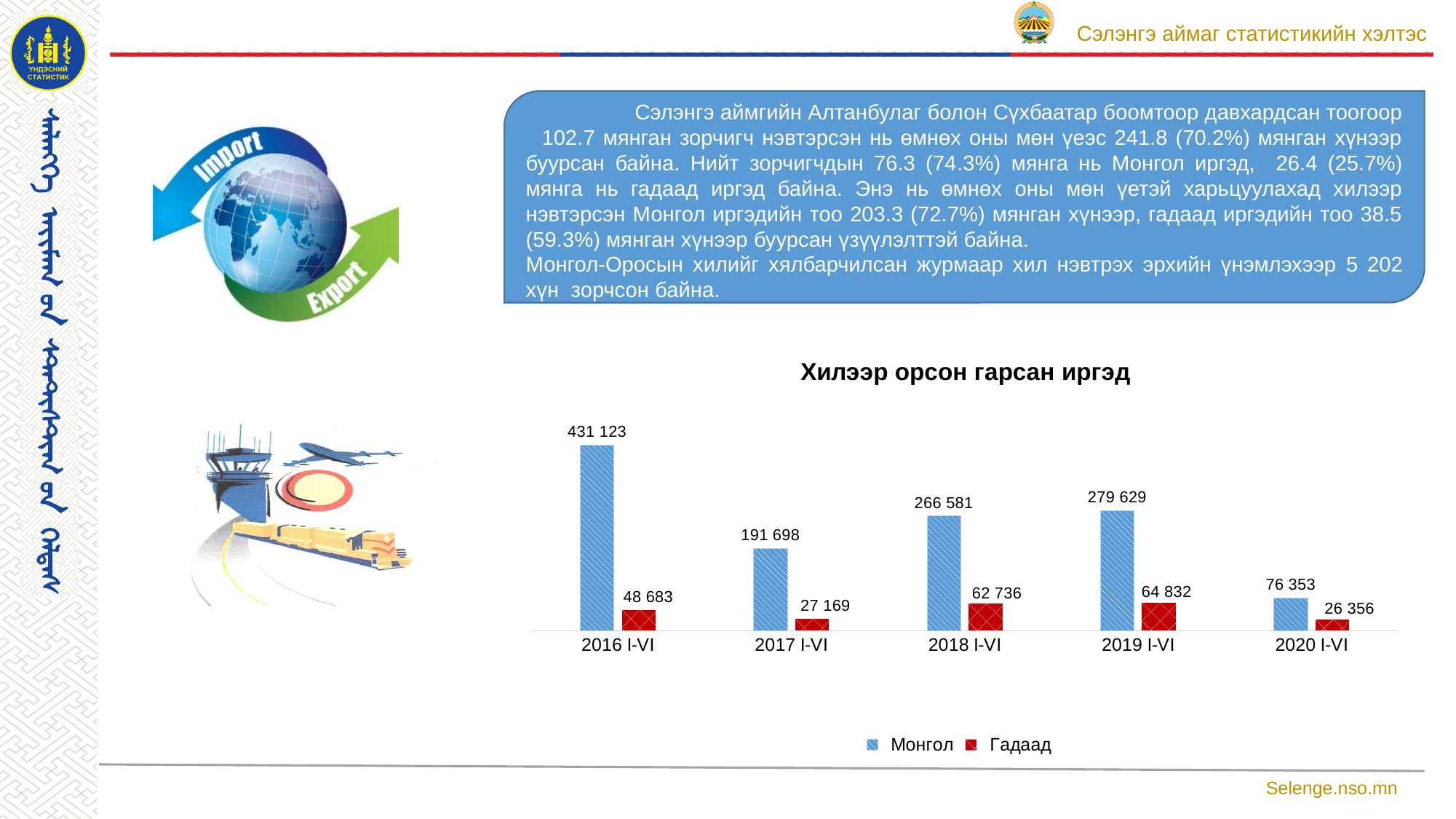
What is the value for Гадаад in 2017 I-VI? 27 169 How many periods are shown on the x axis? 5 Which is larger: the Монгол value in 2018 I-VI or in 2019 I-VI? 2019 I-VI What is the difference between the Монгол and Гадаад values in 2016 I-VI? 382 440 In which period is the Гадаад value highest? 2019 I-VI In which period is the Монгол value highest? 2016 I-VI What type of chart is shown under the title 'Хилээр орсон гарсан иргэд'? bar chart What is the value for Монгол in 2016 I-VI? 431 123 In which period is the Монгол value lowest? 2020 I-VI How many series does the legend list? 2 What is the value for Гадаад in 2019 I-VI? 64 832 What is the value for Монгол in 2020 I-VI? 76 353